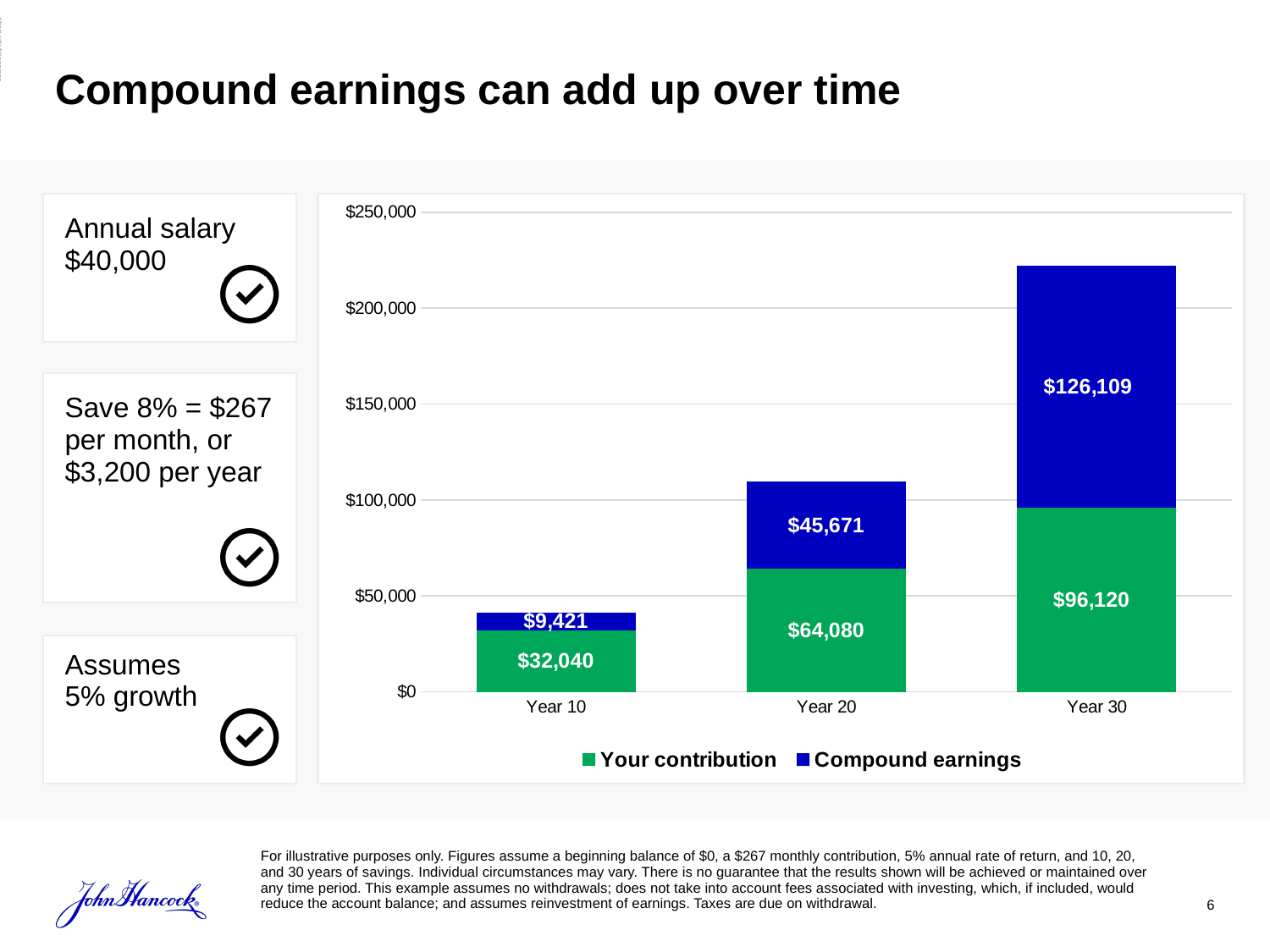
How many series does the legend list? 2 What is the difference between Your contribution for Year 30 and Year 20? $32,040 Which year has the highest Compound earnings value? Year 30 What kind of chart is shown on the slide? Stacked bar chart How many years (categories) are shown on the x axis? 3 Is the total height of the Year 30 bar greater or less than $200,000? greater What is the value of Compound earnings for Year 30? $126,109 What is the value of Compound earnings for Year 20? $45,671 What is the value of Your contribution for Year 10? $32,040 Which year has the lowest Your contribution value? Year 10 What is the total of the stacked bar for Year 20? $109,751 For Year 30, which is larger: Your contribution or Compound earnings? Compound earnings